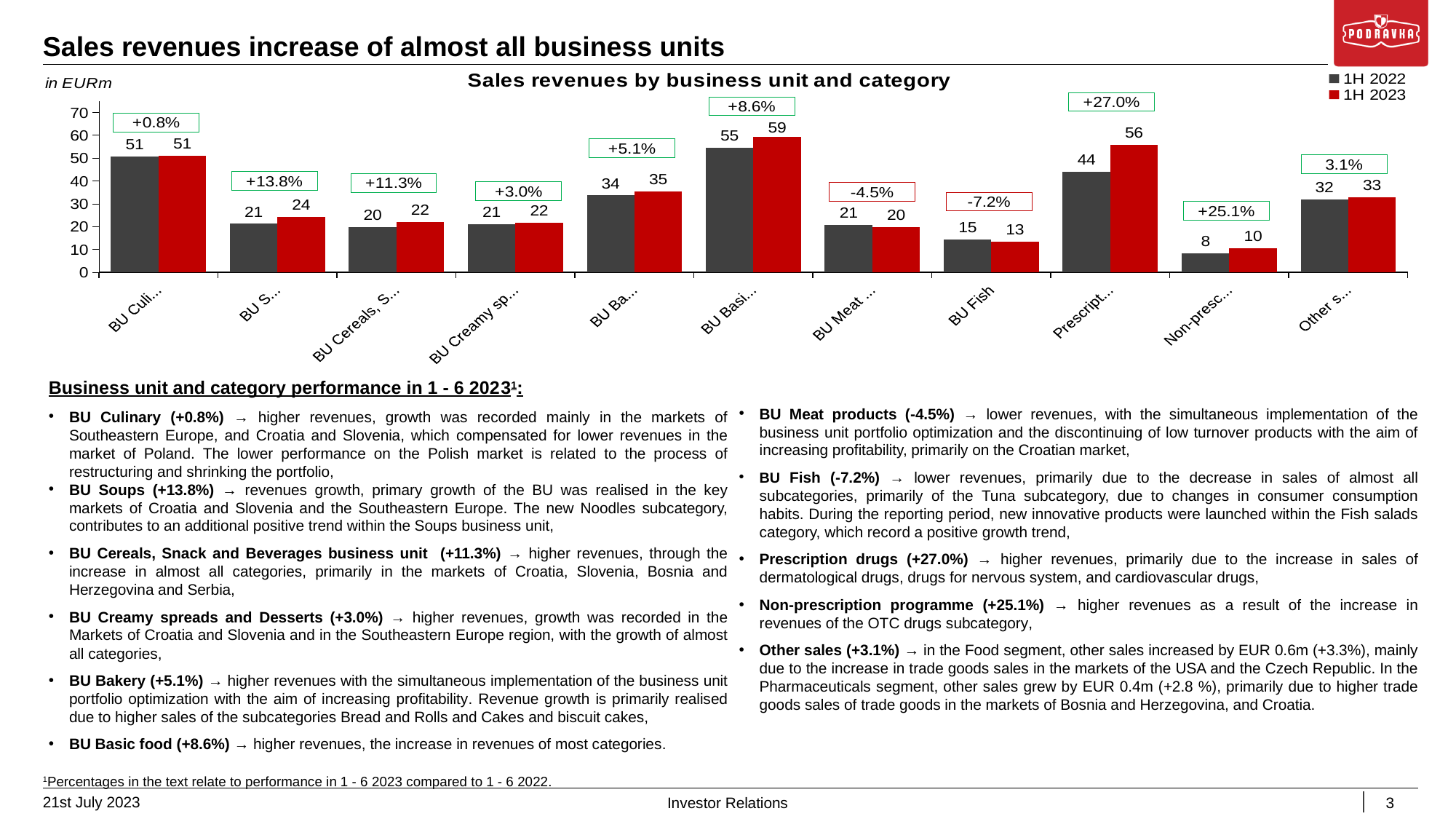
By how much did Prescription drugs sales revenue increase from 1H 2022 to 1H 2023 according to the chart? 12 What is the difference between the 1H 2023 and 1H 2022 values for BU Basic food? 4 For BU Fish, which is larger: the 1H 2022 value or the 1H 2023 value? 1H 2022 How many series does the legend of the 'Sales revenues by business unit and category' chart list? 2 What is the 1H 2022 sales revenue value for Prescription drugs? 44 How many business unit/category groups are plotted on the x axis of the chart? 11 What percentage change is shown above the bars for BU Meat products? -4.5% Which category has the lowest 1H 2022 sales revenue in the chart? Non-prescription programme What type of chart is shown on the slide? Bar chart Which business unit has the highest 1H 2023 sales revenue in the chart? BU Basic food What are the two legend entries of the chart? 1H 2022 and 1H 2023 What is the 1H 2023 sales revenue value for BU Fish? 13